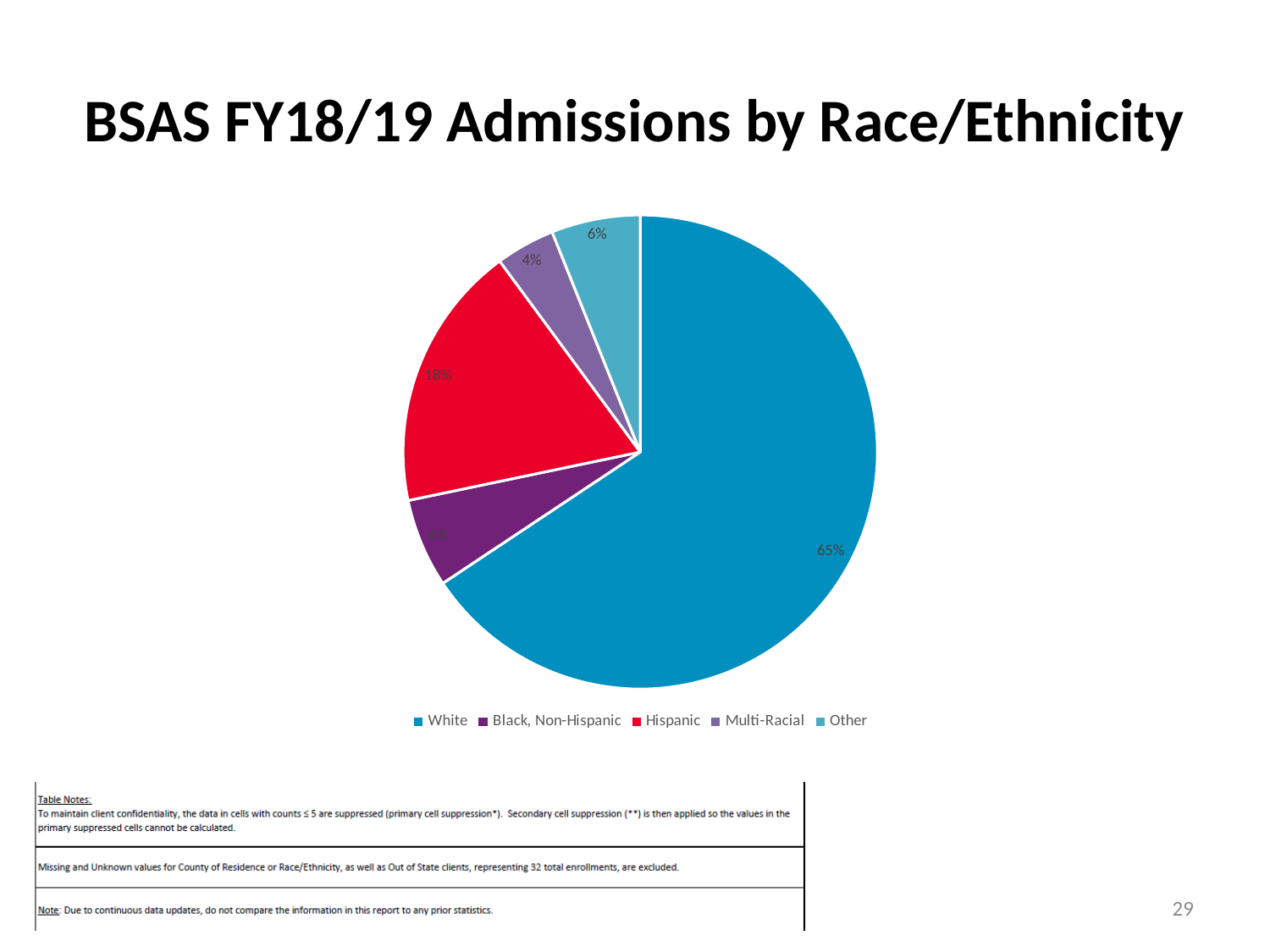
What colour is the Hispanic slice in the pie chart? red What is the title of the slide? BSAS FY18/19 Admissions by Race/Ethnicity What percentage of admissions is shown for White? 65% Which race/ethnicity category has the largest share of admissions? White What kind of chart is shown on the slide? pie chart Which race/ethnicity category has the smallest share of admissions? Multi-Racial What percentage of admissions is shown for Other? 6% What percentage of admissions is shown for Hispanic? 18% What percentage of admissions is shown for Multi-Racial? 4% How many race/ethnicity categories does the pie chart show? 5 How many percentage points larger is the White share than the Hispanic share? 47 Which is larger, the share for Hispanic or the share for Other? Hispanic